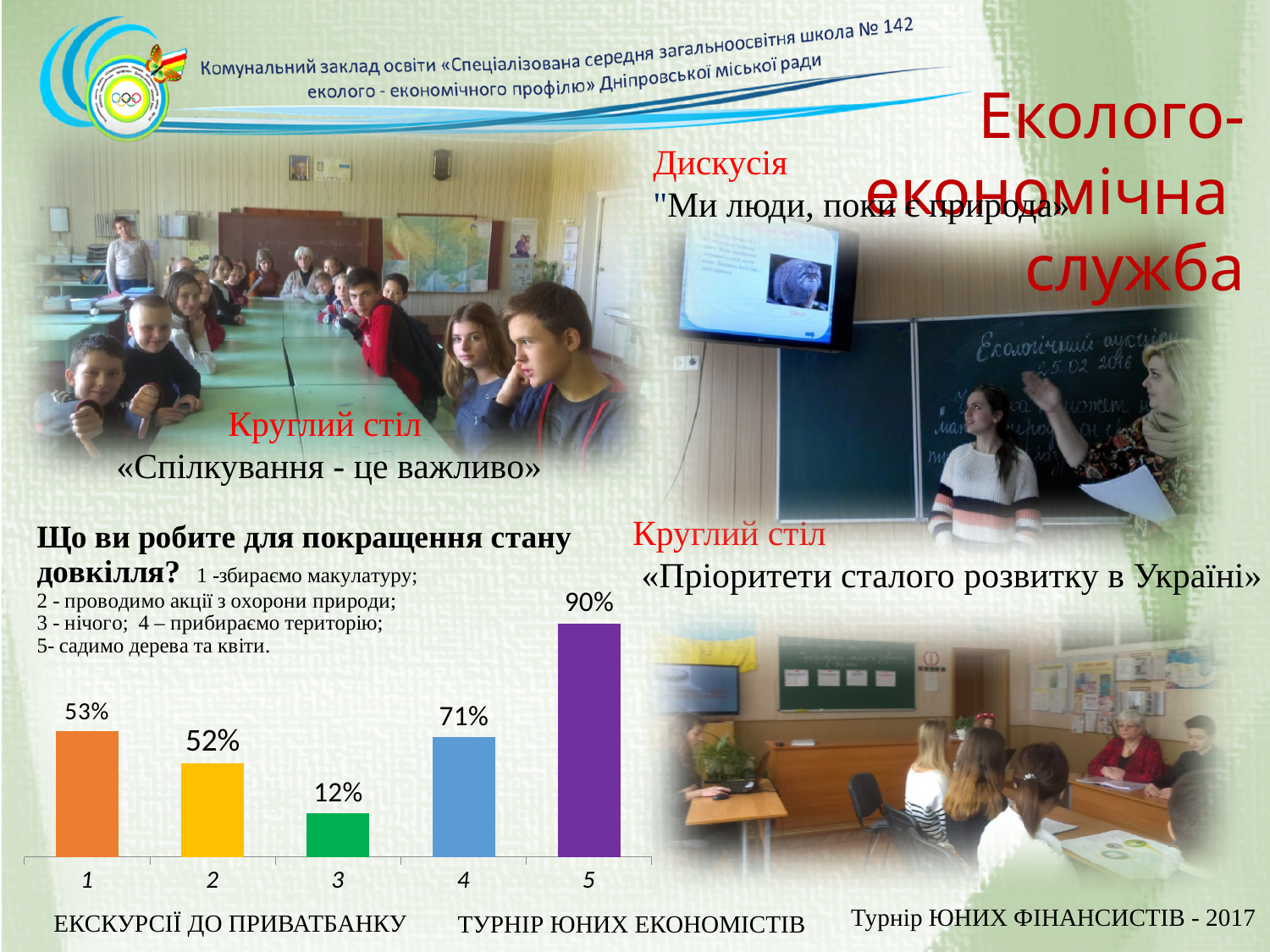
What is the value for category 5 in the bar chart? 90% What is the value for category 3 in the bar chart? 12% What is the difference between the values for category 1 and category 3? 41% How many categories are shown in the bar chart? 5 Which is larger, the value for category 4 or the value for category 2? 4 What colour is the bar for category 5? purple Which category has the lowest value in the bar chart? 3 What is the difference between the values for category 5 and category 4? 19% What type of chart is shown on the slide? bar chart What is the value for category 1 in the bar chart? 53% What is the value for category 4 in the bar chart? 71% Which category has the highest value in the bar chart? 5